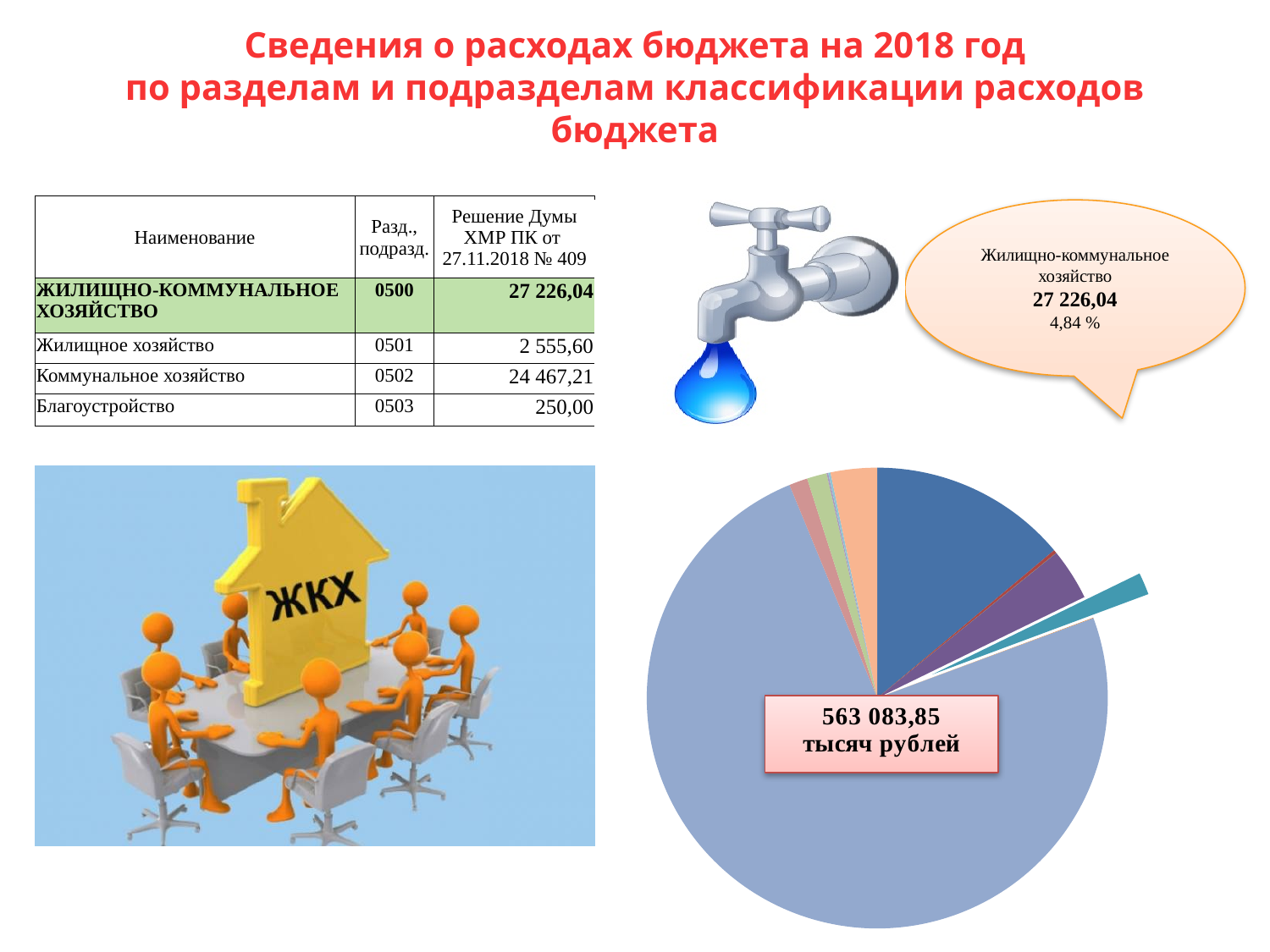
What value is given for Жилищно-коммунальное хозяйство in the callout above the pie chart? 27 226,04 What colour is the largest slice of the pie chart? light blue What kind of chart is shown at the bottom right of the slide? pie chart According to the callout next to the pie chart, what share of the budget does Жилищно-коммунальное хозяйство represent? 4,84 % What total amount is printed on the pie chart? 563 083,85 тысяч рублей What colour is the slice that is pulled out (exploded) from the pie chart? teal